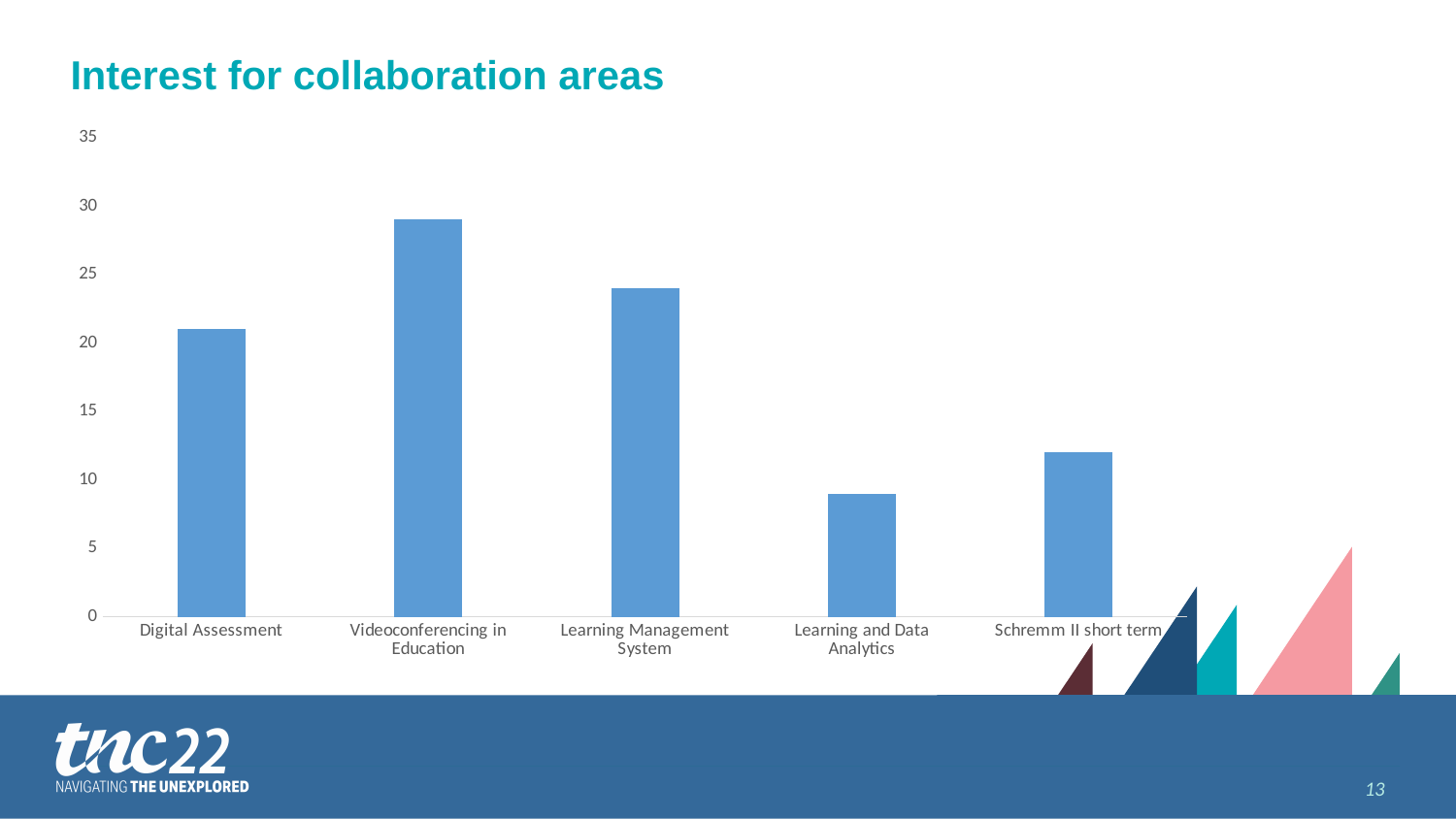
Is the value for Schremm II short term greater or less than 10? greater Is the value for Videoconferencing in Education greater or less than 25? greater What is the title of the chart? Interest for collaboration areas How many categories are shown on the x axis? 5 What kind of chart is shown on the slide? bar chart Is the value for Digital Assessment greater or less than 15? greater Which category has the lowest value? Learning and Data Analytics Which category has the highest value? Videoconferencing in Education Which is larger, the value for Digital Assessment or the value for Learning Management System? Learning Management System Which is larger, the value for Schremm II short term or the value for Learning and Data Analytics? Schremm II short term